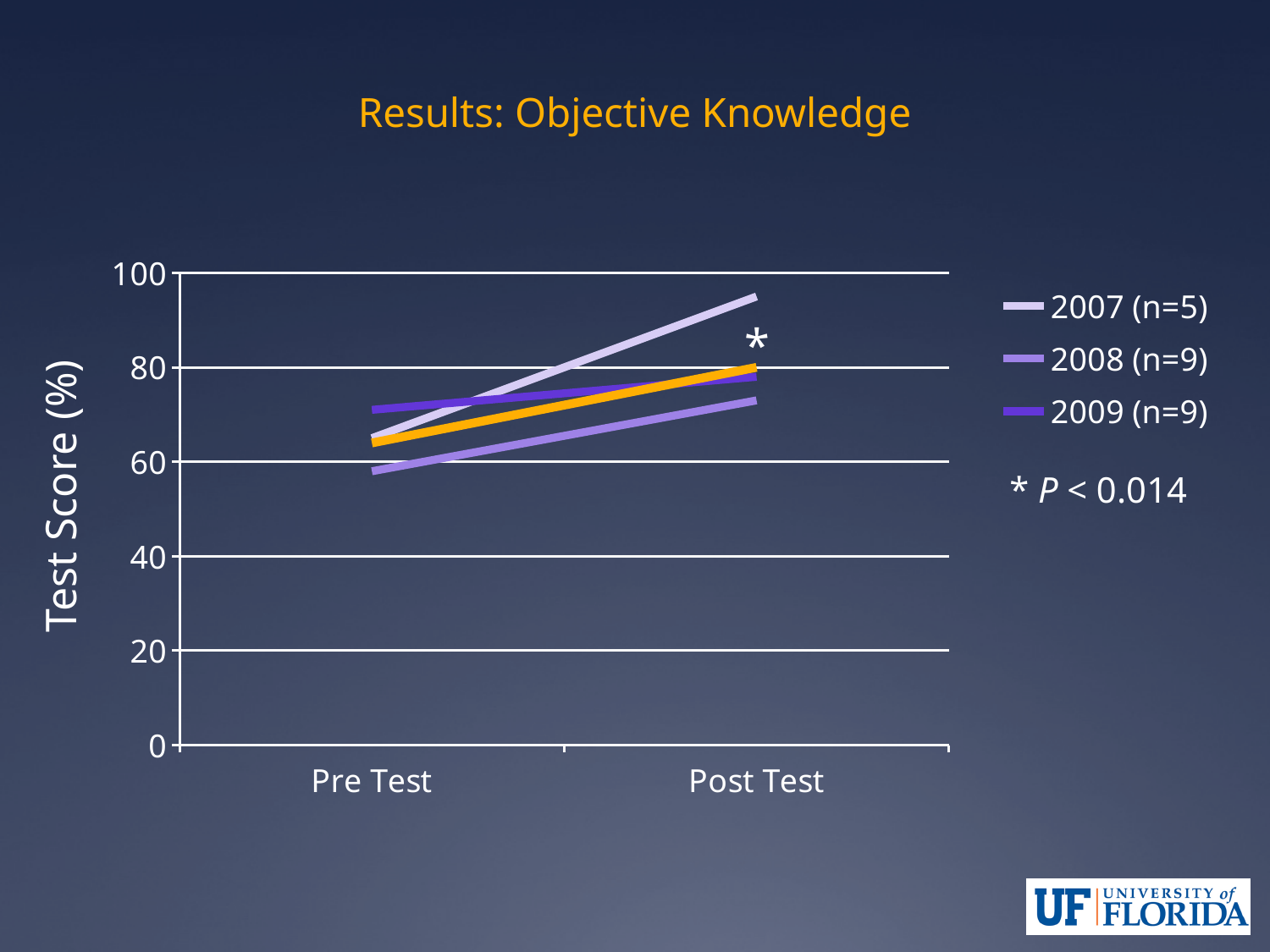
Do the test scores rise or fall from Pre Test to Post Test? Rise How many series does the legend list? 3 Is the Post Test value for 2008 (n=9) greater or less than 60? greater Which series has the highest test score at Post Test? 2007 (n=5) Is the Pre Test value for 2009 (n=9) greater or less than 60? greater Which series has the highest test score at Pre Test? 2009 (n=9) What kind of chart is shown on the slide? Line chart What is the label on the y axis of the chart? Test Score (%) Is the Post Test value for 2007 (n=5) greater or less than 80? greater At Post Test, which is larger: the value for 2007 (n=5) or 2008 (n=9)? 2007 (n=5) How many categories are shown on the x axis? 2 Which series has the lowest test score at Pre Test? 2008 (n=9)